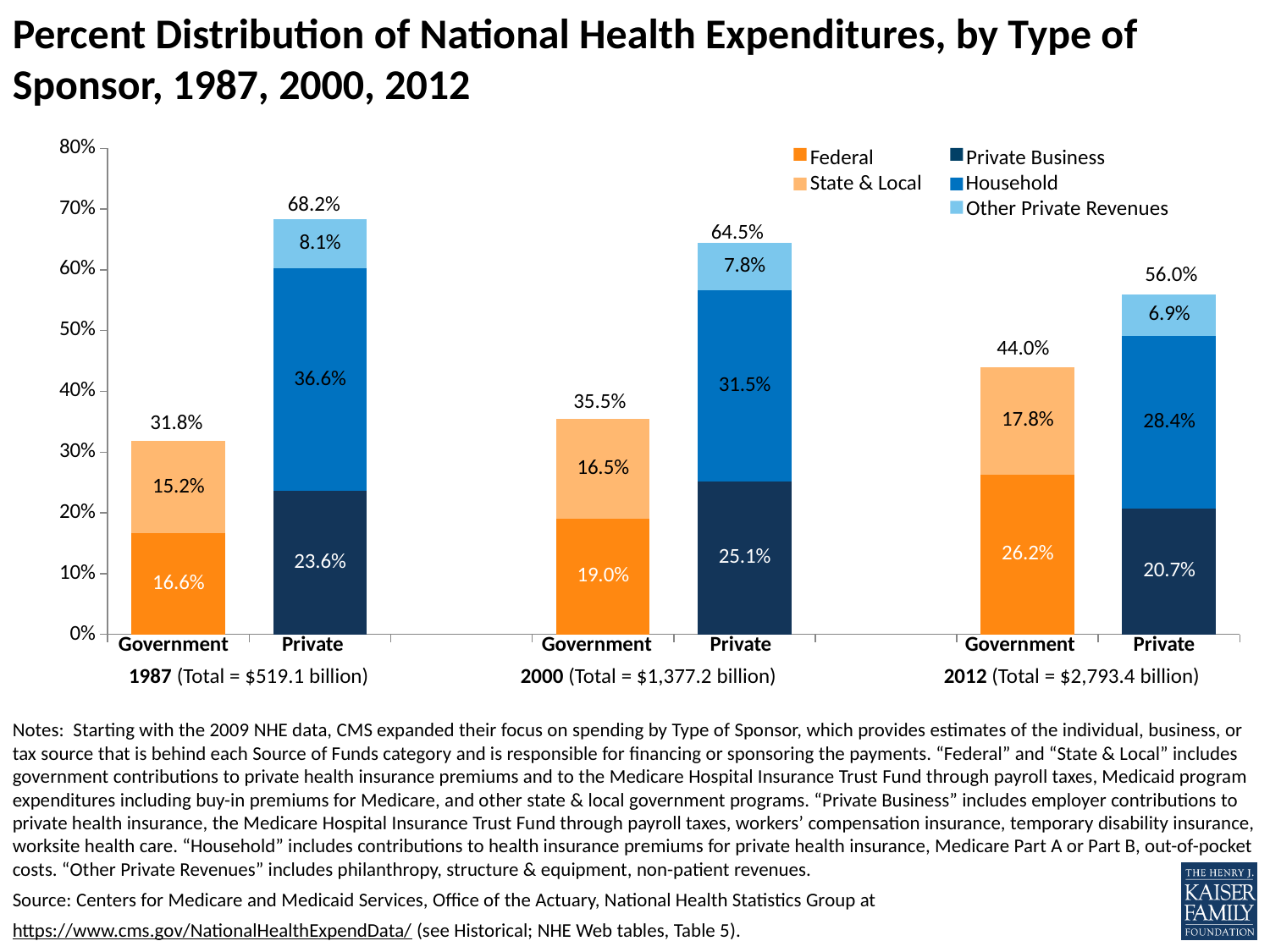
What is the total national health expenditure shown for 2012? $2,793.4 billion How does the Private total change across 1987, 2000 and 2012? It falls (68.2% to 64.5% to 56.0%) What kind of chart is shown on the slide? Stacked bar chart Which is larger: the State & Local share for Government in 2000 or the Other Private Revenues share for Private in 2000? State & Local for Government in 2000 (16.5%) Which bar has the highest total percentage? Private, 1987 (68.2%) What is the Household share for Private in 1987? 36.6% What is the total for the Private bar in 2000? 64.5% How many bars are plotted in the chart? 6 What is the Federal share of national health expenditures for Government in 2012? 26.2% What is the difference between the Government total in 2012 and the Government total in 1987? 12.2 percentage points Which bar has the lowest total percentage? Government, 1987 (31.8%) How many series does the legend list? 5